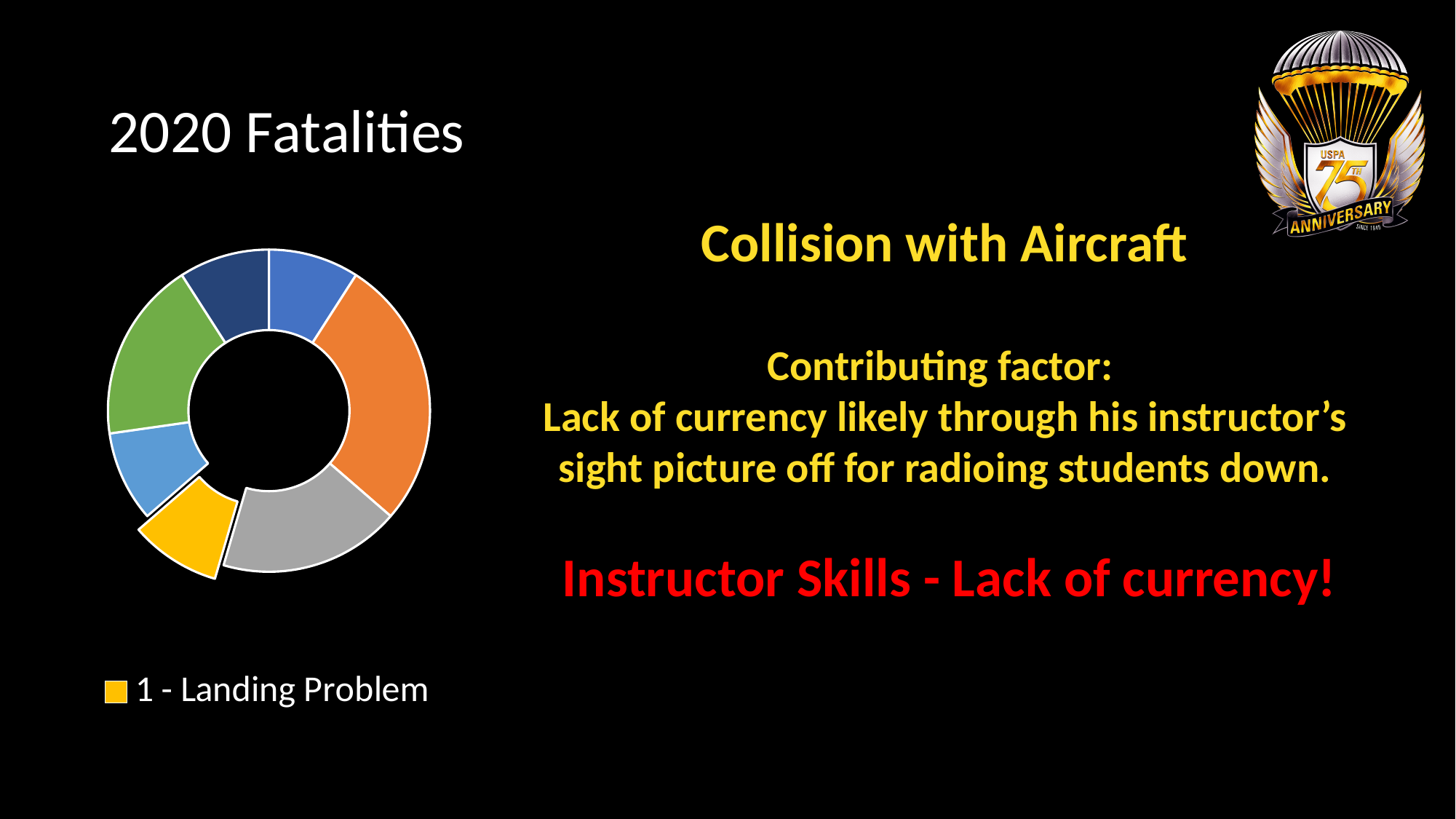
What kind of chart is shown on the slide? Doughnut (pie) chart According to the legend, how many fatalities are attributed to Landing Problem? 1 How many entries does the chart legend list? 1 How many slices does the doughnut chart have? 7 What is the title of the slide containing the chart? 2020 Fatalities Which is larger, the orange slice or the yellow (Landing Problem) slice? Orange Which is larger, the orange slice or the gray slice? Orange Which is larger, the green slice or the yellow (Landing Problem) slice? Green What is the only legend entry shown for the chart? 1 - Landing Problem Which colour slice is the largest in the doughnut chart? Orange